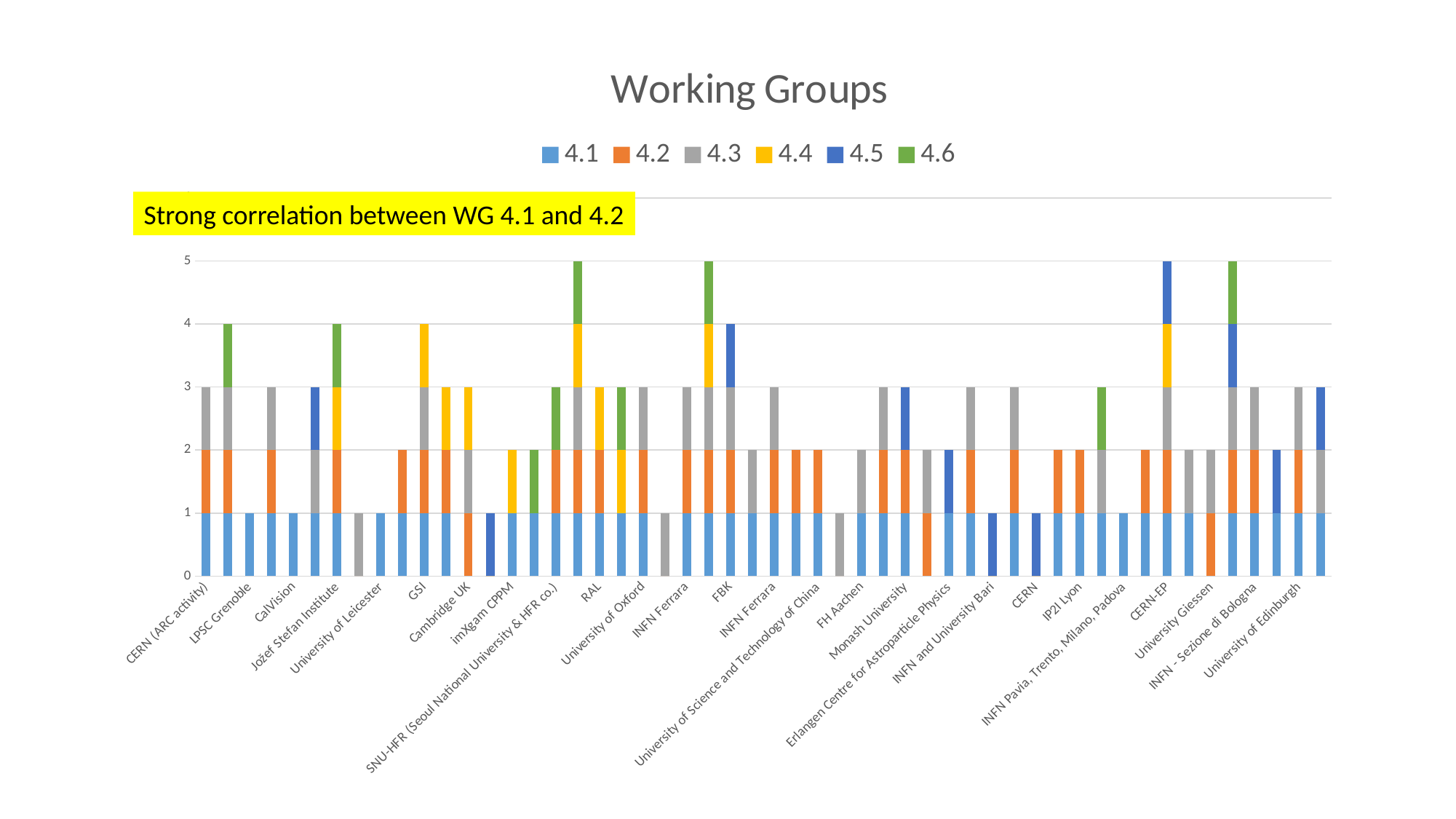
What is the total height of the stacked bar for CERN-EP? 5 Is the total for CERN-EP greater or less than 4? greater Which has the taller stacked bar, CERN-EP or LPSC Grenoble? CERN-EP Which has the taller stacked bar, GSI or University of Leicester? GSI What is the title of the chart? Working Groups What is the total height of the stacked bar for RAL? 3 What is the total height of the stacked bar for GSI? 4 Is the total for LPSC Grenoble greater or less than 2? less How many series does the legend list? 6 Which series is shown in yellow in the legend? 4.4 What kind of chart is shown on the slide? Stacked bar chart